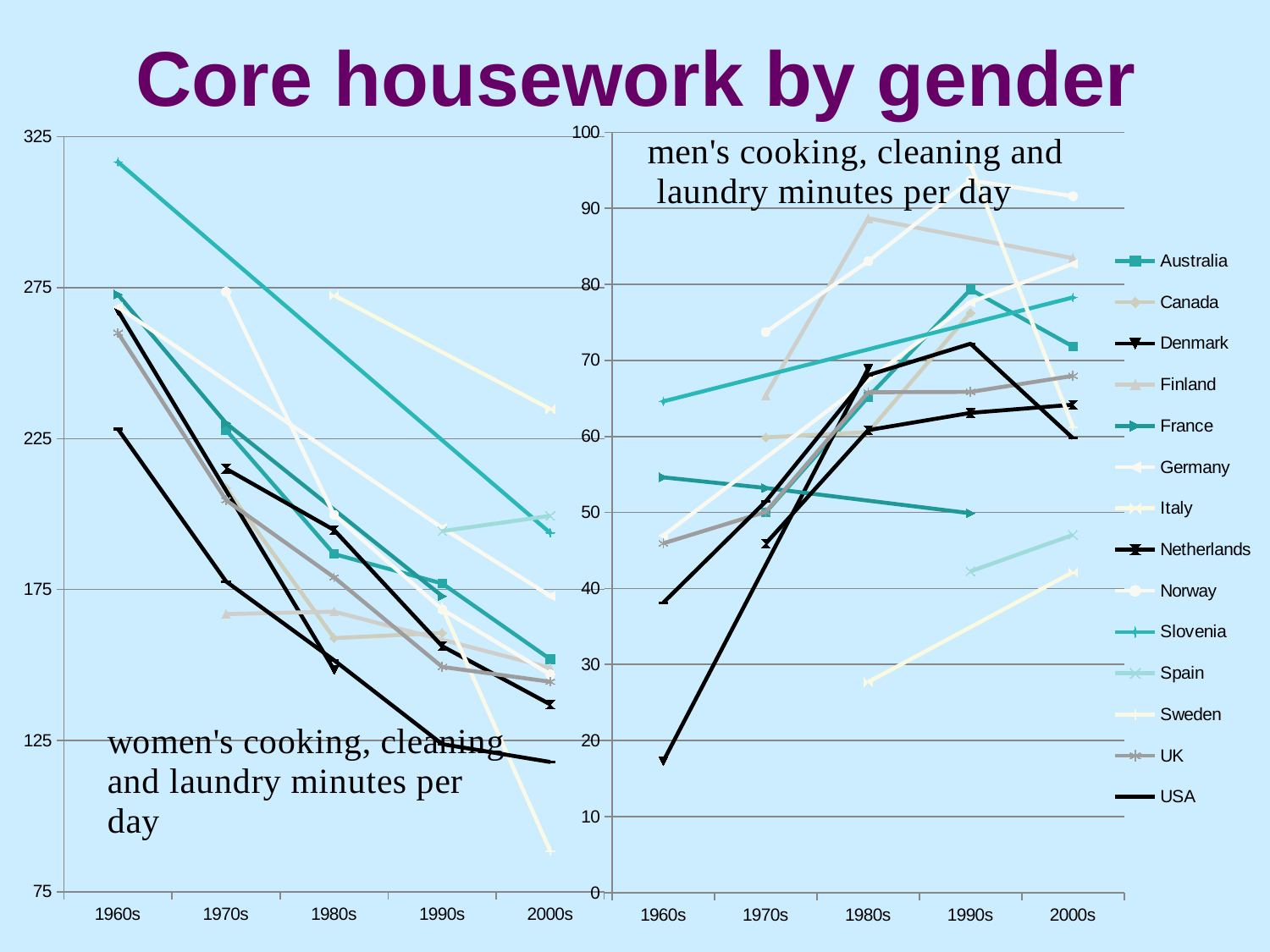
In the men's cooking, cleaning and laundry chart, do the values for the USA rise or fall from the 1960s to the 1990s? rise In the men's cooking, cleaning and laundry chart, which country has the lowest value in the 1960s? Denmark How many decades are shown on the x axis of the men's cooking, cleaning and laundry chart? 5 In the women's cooking, cleaning and laundry chart, do the values generally rise or fall from the 1960s to the 2000s? fall In the men's cooking, cleaning and laundry chart, is the value for Norway in the 2000s greater or less than 90? greater In the women's cooking, cleaning and laundry chart, is the value for Slovenia in the 1960s greater or less than 275? greater What kind of chart is the women's cooking, cleaning and laundry chart on the left? line chart How many countries does the legend list? 14 In the women's cooking, cleaning and laundry chart, is the value for the USA in the 2000s greater or less than 125? less In the women's cooking, cleaning and laundry chart, which country has the highest value in the 1960s? Slovenia What is the title of the slide? Core housework by gender